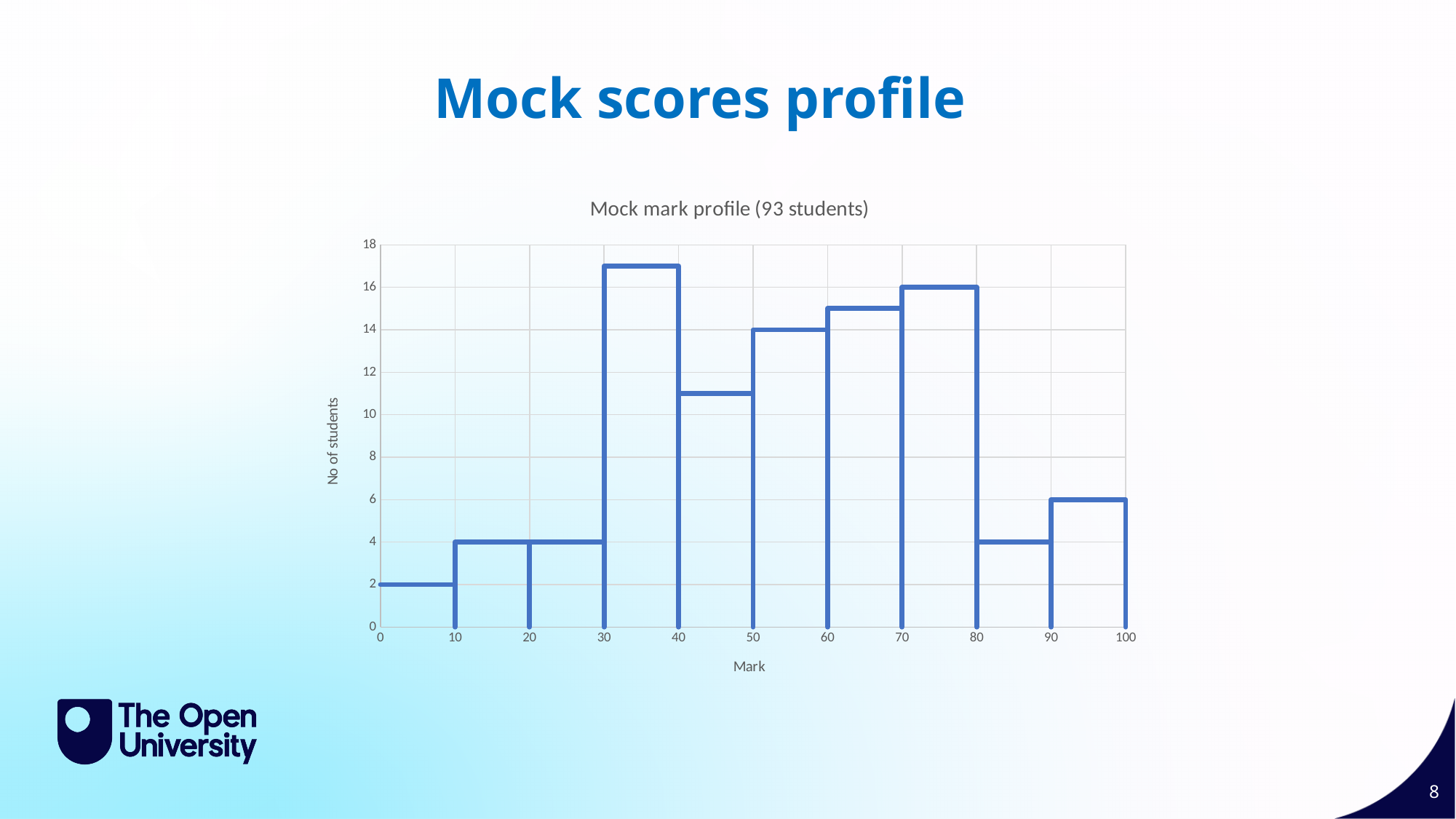
How many students scored between 50 and 60? 14 Which has more students: the 70 to 80 range or the 50 to 60 range? 70 to 80 What is the title of the chart? Mock mark profile (93 students) Which mark range has the highest number of students? 30 to 40 Which mark range has the lowest number of students? 0 to 10 How many students scored between 10 and 20? 4 Is the number of students scoring between 40 and 50 greater or less than 12? less How many students scored between 70 and 80? 16 Is the number of students scoring between 30 and 40 greater or less than 16? greater How many students scored between 0 and 10? 2 What is the label of the vertical axis? No of students How many students scored between 90 and 100? 6